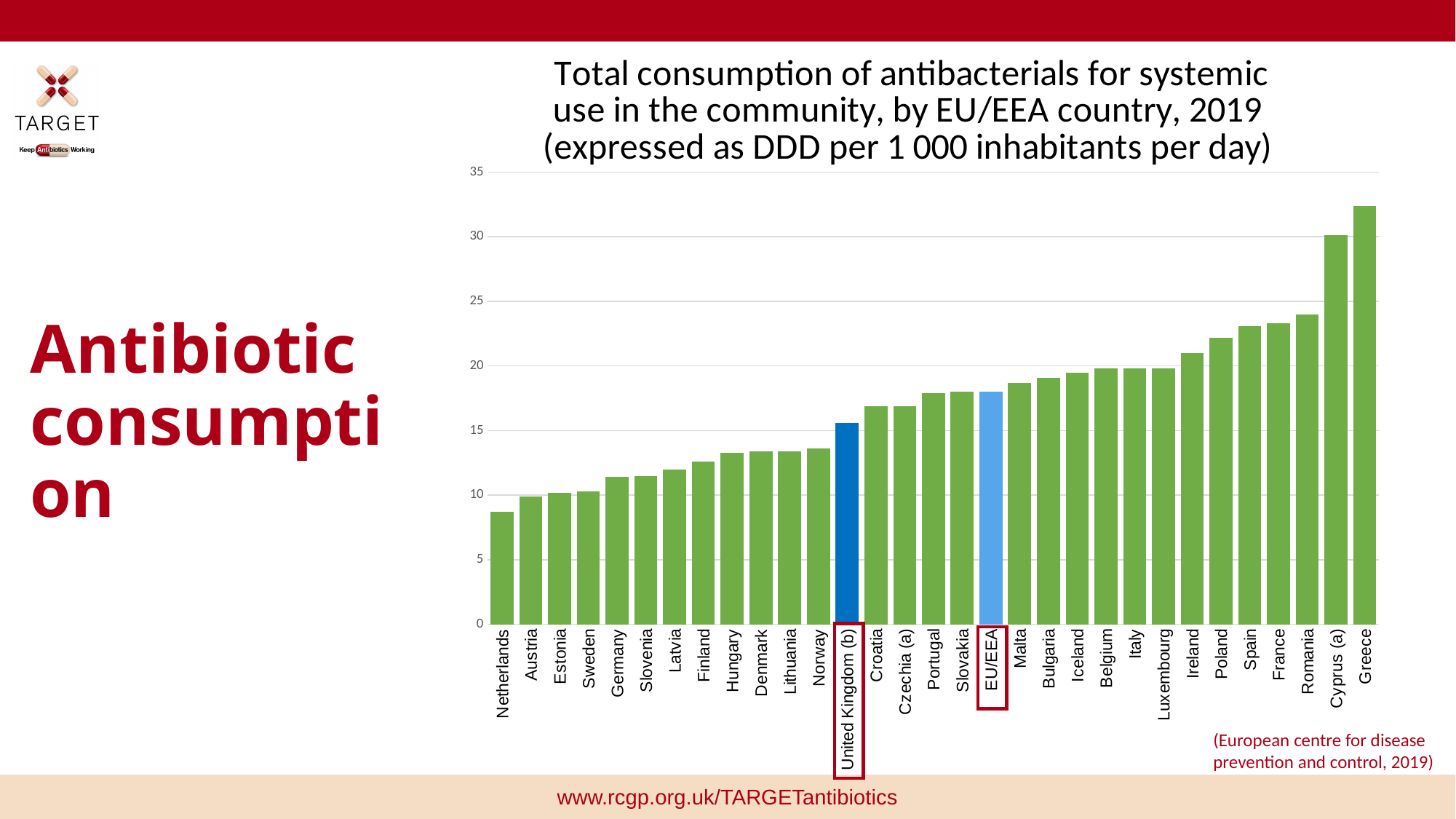
What is the title of the chart? Total consumption of antibacterials for systemic use in the community, by EU/EEA country, 2019 (expressed as DDD per 1 000 inhabitants per day) Is the value for United Kingdom (b) greater or less than 15? greater Which category has the highest antibiotic consumption on the chart? Greece Is the value for Greece greater or less than 30? greater Do the bar values rise or fall moving from left to right along the x axis? rise How many countries/categories are plotted on the chart? 31 Is the value for Netherlands greater or less than 10? less Which is larger, the value for United Kingdom (b) or the value for EU/EEA? EU/EEA What kind of chart is shown on the slide? bar chart Which category has the lowest antibiotic consumption on the chart? Netherlands